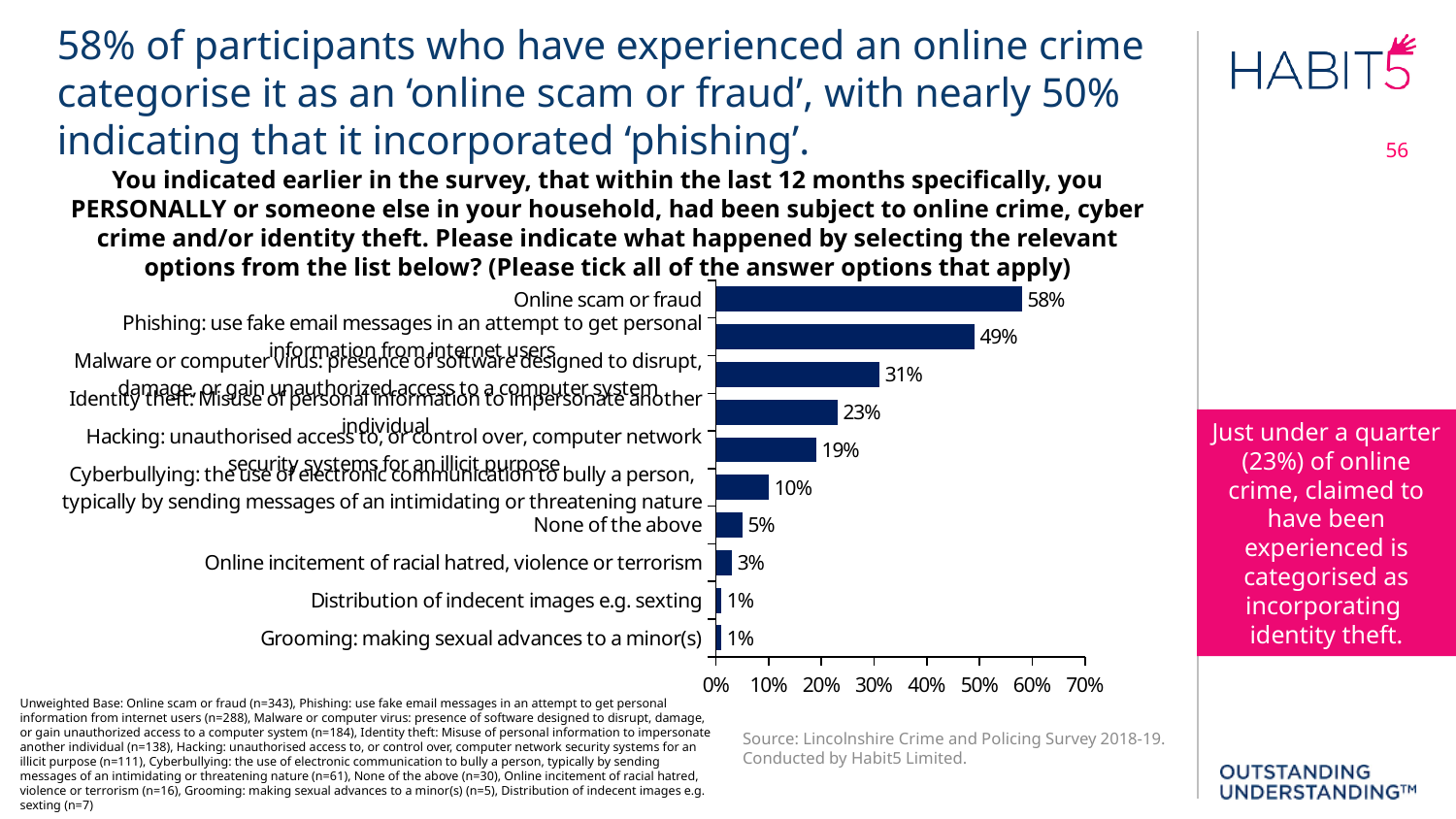
What is the highest value shown on the chart's percentage axis? 70% Which category has the highest value in the chart? Online scam or fraud What kind of chart is shown on the slide? Bar chart What value is shown for 'Grooming: making sexual advances to a minor(s)'? 1% What percentage is shown for 'None of the above'? 5% Is the value for 'Phishing' greater or less than 40%? greater What is the difference between the values for 'Online scam or fraud' and 'Phishing'? 9% What is the value shown for 'Hacking: unauthorised access to, or control over, computer network security systems for an illicit purpose'? 19% What percentage of participants selected 'Online scam or fraud'? 58% How many categories are plotted in the chart? 10 Which is larger: the value for 'Cyberbullying' or the value for 'Online incitement of racial hatred, violence or terrorism'? Cyberbullying What is the difference between the values for 'Malware or computer virus' and 'Identity theft'? 8%